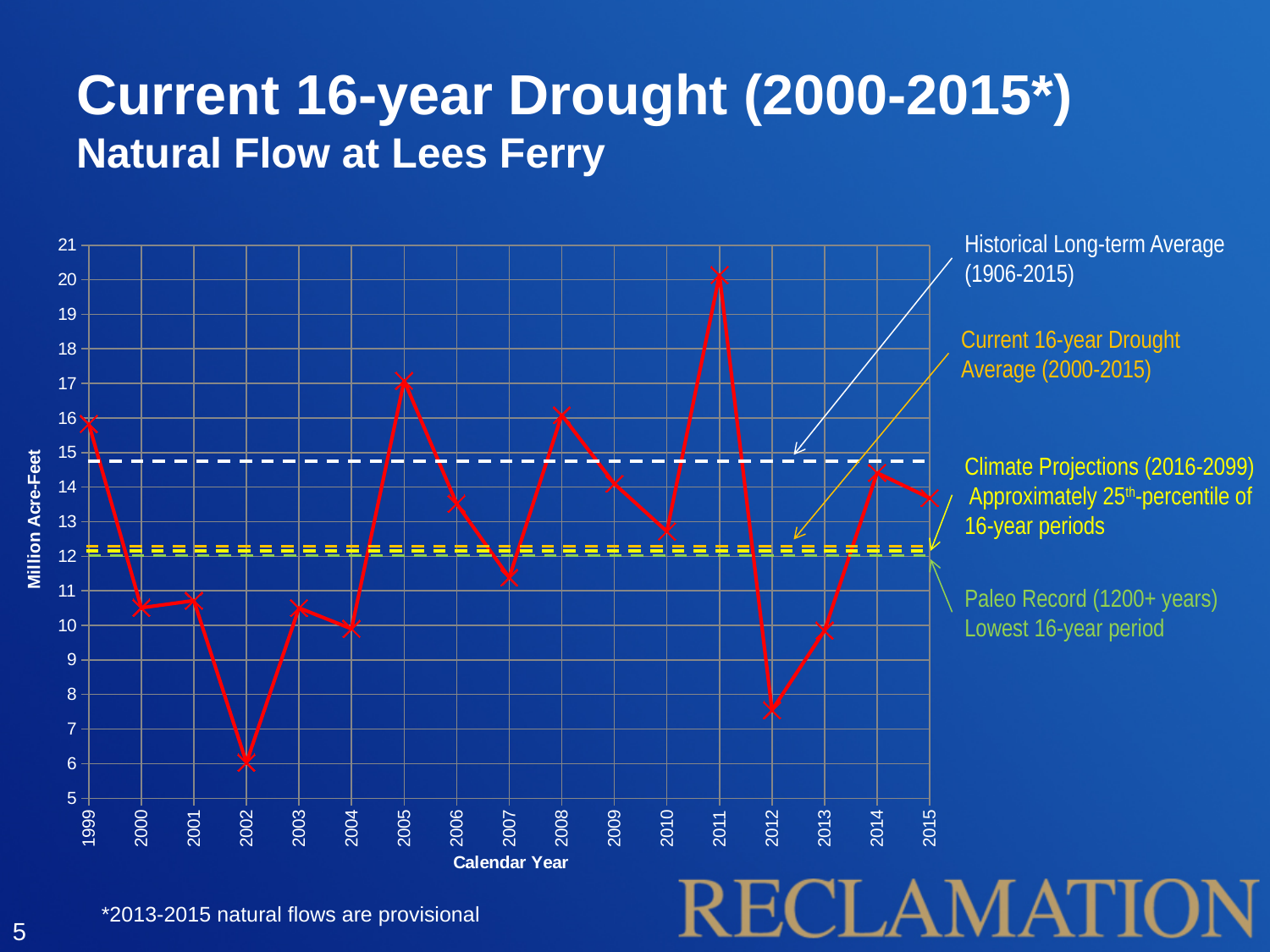
What is the label on the y axis of the chart? Million Acre-Feet Is the natural flow for 2005 greater or less than 16 million acre-feet? greater Which calendar year has the highest natural flow on the chart? 2011 Which calendar year has the lowest natural flow on the chart? 2002 What kind of chart is shown on the slide? line chart How many calendar years are plotted on the x axis? 17 Which year has the larger natural flow, 2005 or 2008? 2005 Is the natural flow for 2002 greater or less than 7 million acre-feet? less Is the natural flow for 2011 greater or less than 19 million acre-feet? greater Which year has the larger natural flow, 2002 or 2012? 2012 Does the natural flow rise or fall from 2011 to 2012? fall